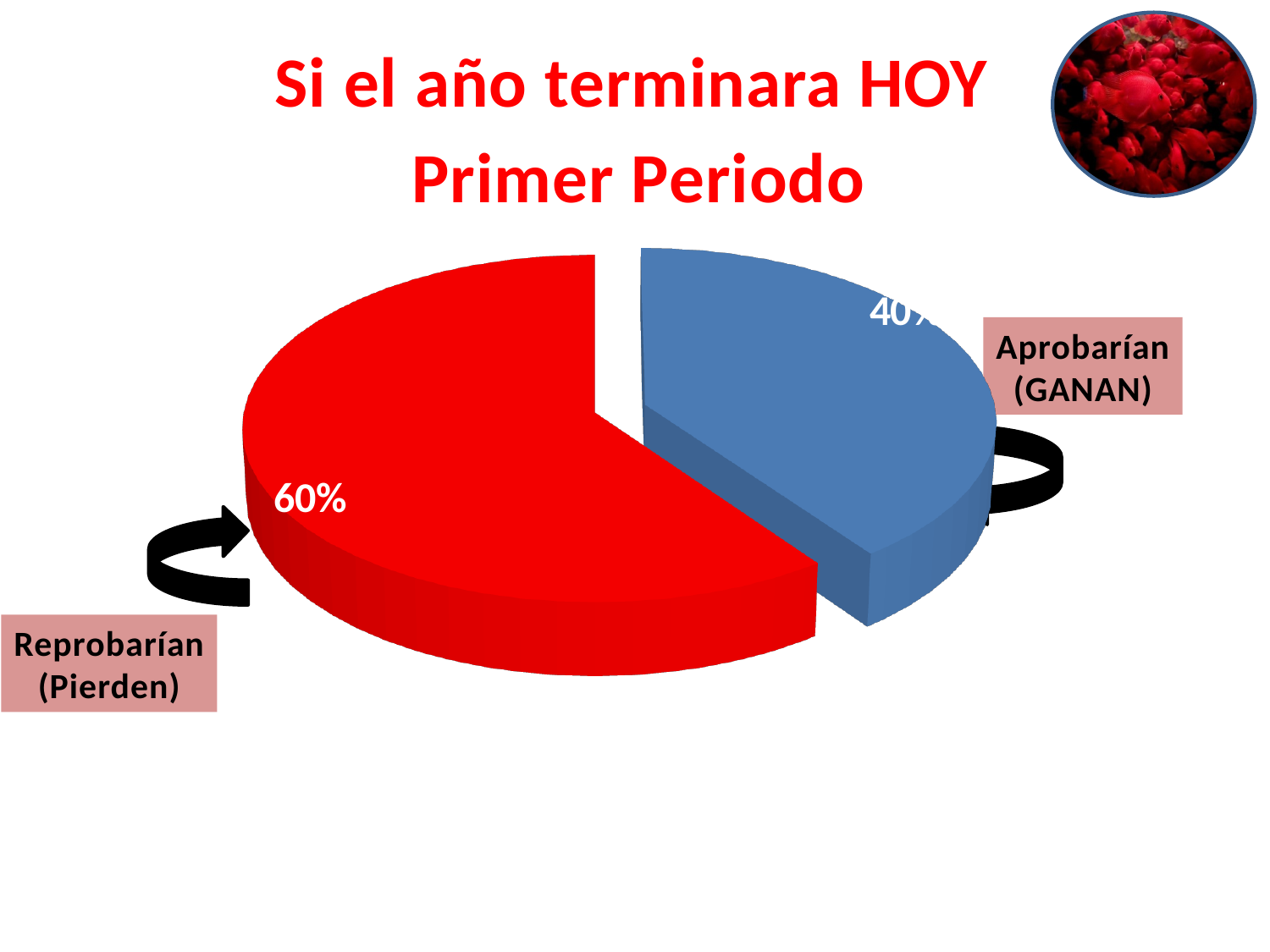
What percentage of the pie corresponds to Reprobarían (Pierden)? 60% What colour is the slice for Aprobarían (GANAN)? blue What kind of chart is shown on the slide? pie chart What percentage of the pie corresponds to Aprobarían (GANAN)? 40% Which slice of the pie is the smallest? Aprobarían (GANAN) How many slices does the pie chart have? 2 What is the difference in percentage points between the Reprobarían (Pierden) slice and the Aprobarían (GANAN) slice? 20 What share of the pie does the red slice represent? 60% Which slice of the pie is the largest? Reprobarían (Pierden) What is the title shown above the pie chart? Si el año terminara HOY Primer Periodo Which is larger, the share for Reprobarían (Pierden) or the share for Aprobarían (GANAN)? Reprobarían (Pierden)